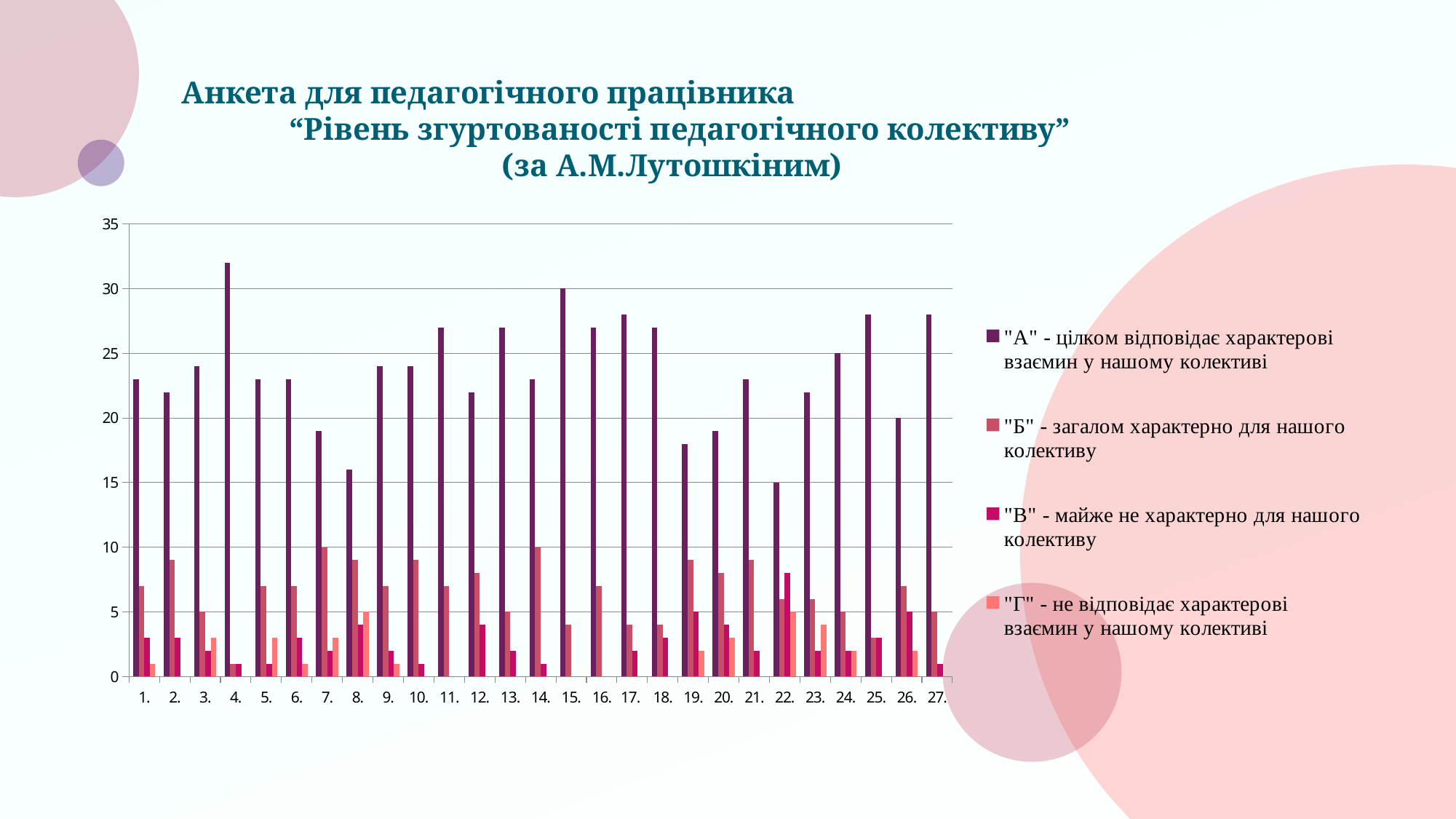
Which category has the highest value for the "А" series? 4. What kind of chart is shown on the slide? bar chart Is the value of the "А" series for category 22. greater or less than 20? less What is the value of the "А" series for category 26.? 20 How many series does the legend list? 4 Which series is shown in the lightest (salmon) colour in the legend? "Г" - не відповідає характерові взаємин у нашому колективі How many categories are shown along the x axis? 27 Is the value of the "А" series for category 4. greater or less than 30? greater What is the value of the "Б" series for category 7.? 10 For the "А" series, which is larger: category 1. or category 8.? 1. Is the value of the "А" series for category 8. greater or less than 20? less What is the value of the "А" series for category 15.? 30